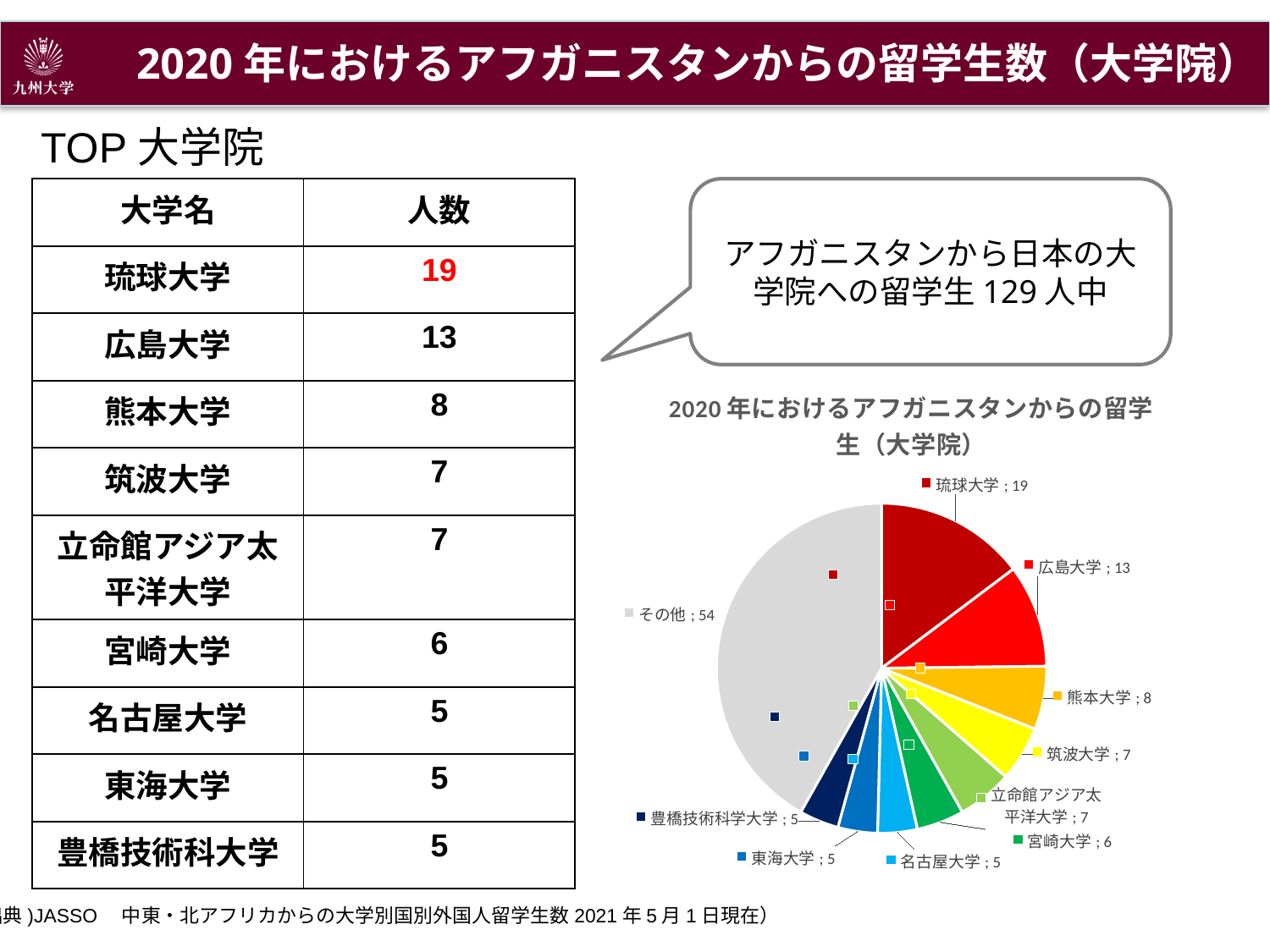
What kind of chart is shown on the slide? pie chart In the pie chart, what is the value for 宮崎大学? 6 In the pie chart, how many students are shown for 琉球大学? 19 What is the difference between the values for 琉球大学 and 広島大学 in the pie chart? 6 In the pie chart, which is larger, the value for 熊本大学 or the value for 宮崎大学? 熊本大学 Among the named universities in the pie chart (excluding その他), which has the highest value? 琉球大学 What is the difference between the values for 熊本大学 and 筑波大学 in the pie chart? 1 In the pie chart, what is the value for その他? 54 What is the title of the pie chart? 2020年におけるアフガニスタンからの留学生（大学院） In the pie chart, what is the value for 広島大学? 13 How many slices does the pie chart have? 10 Which slice of the pie chart is the largest? その他